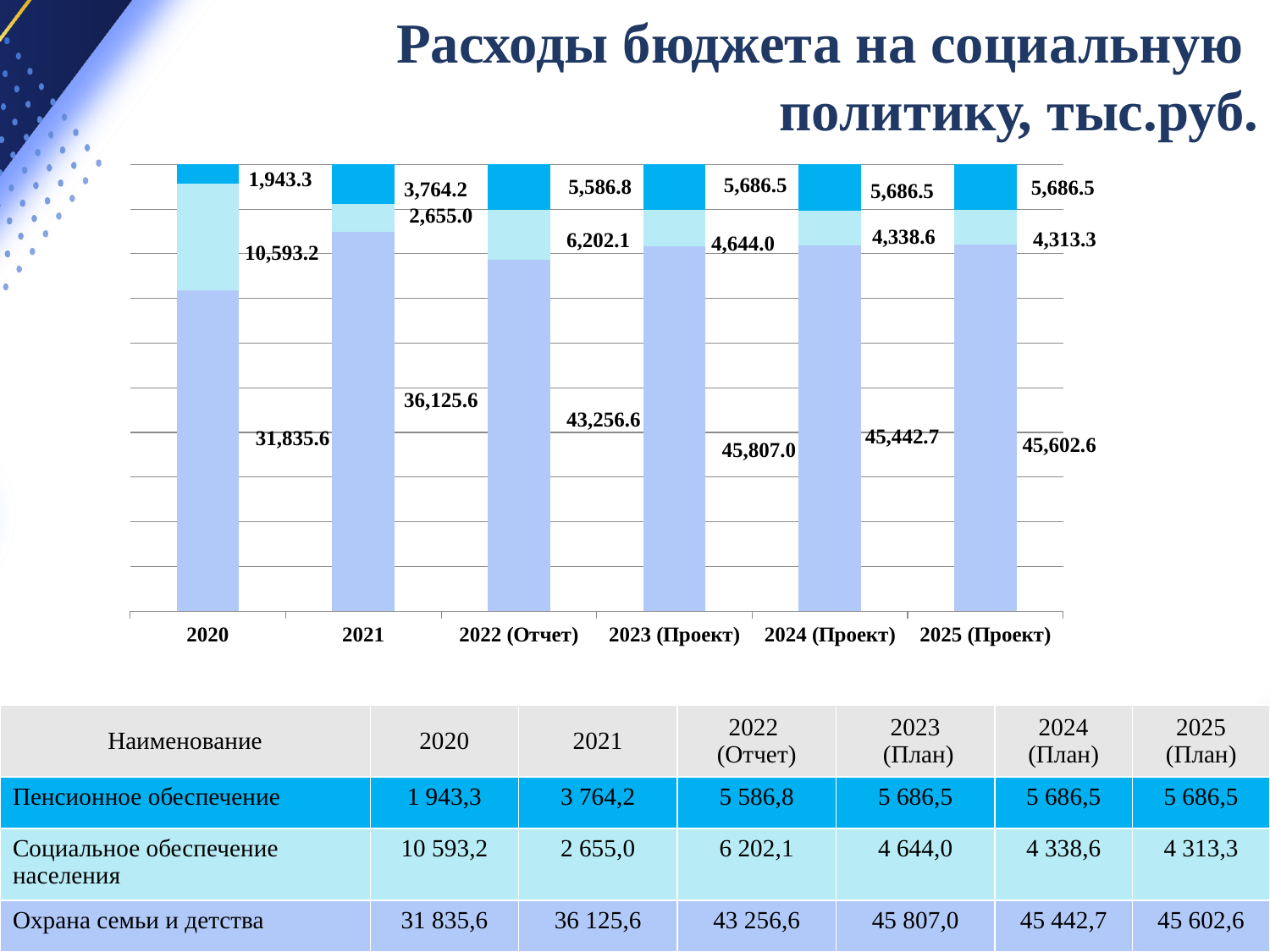
What is the difference between the bottom segment values for 2025 (Проект) and 2020? 13,767.0 In which year is the middle segment (Социальное обеспечение населения) the smallest? 2021 What is the total of the stacked bar for 2020? 44,372.1 What is the value of the middle segment (Социальное обеспечение населения) for 2024 (Проект)? 4,338.6 Which is larger: the middle segment for 2020 or for 2021? 2020 How many year categories are shown along the x axis of the chart? 6 What is the value of the bottom segment (Охрана семьи и детства) for 2020? 31,835.6 In which year is the bottom segment (Охрана семьи и детства) the largest? 2023 (Проект) What is the total of the stacked bar for 2025 (Проект)? 55,602.4 What is the value of the top segment (Пенсионное обеспечение) for 2022 (Отчет)? 5,586.8 Does the bottom segment (Охрана семьи и детства) rise or fall from 2020 to 2023 (Проект)? rise What kind of chart is shown on the slide? stacked bar chart